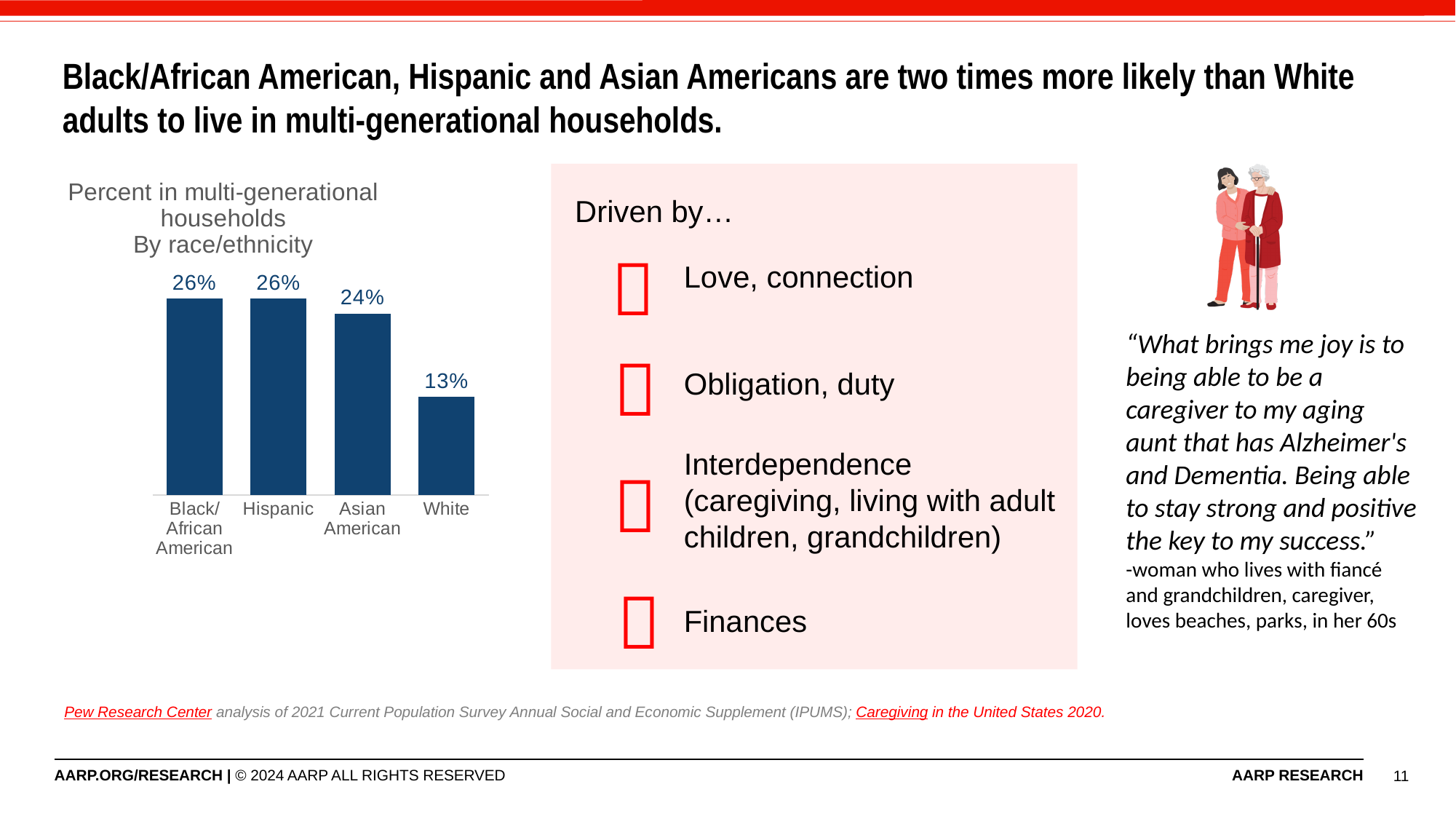
What is the difference between the values for Asian American and White? 11% Which category has the lowest value in the chart? White What is the value for White in the chart? 13% What is the difference between the values for Hispanic and Asian American? 2% Which is larger, the value for Asian American or the value for White? Asian American What is the title of the chart? Percent in multi-generational households By race/ethnicity What is the value for Asian American in the chart? 24% What is the value for Black/African American in the chart? 26% What is the value for Hispanic in the chart? 26% What kind of chart is shown on the slide? Bar chart How many categories are shown in the chart? 4 Do the values rise or fall from left to right across the categories? Fall